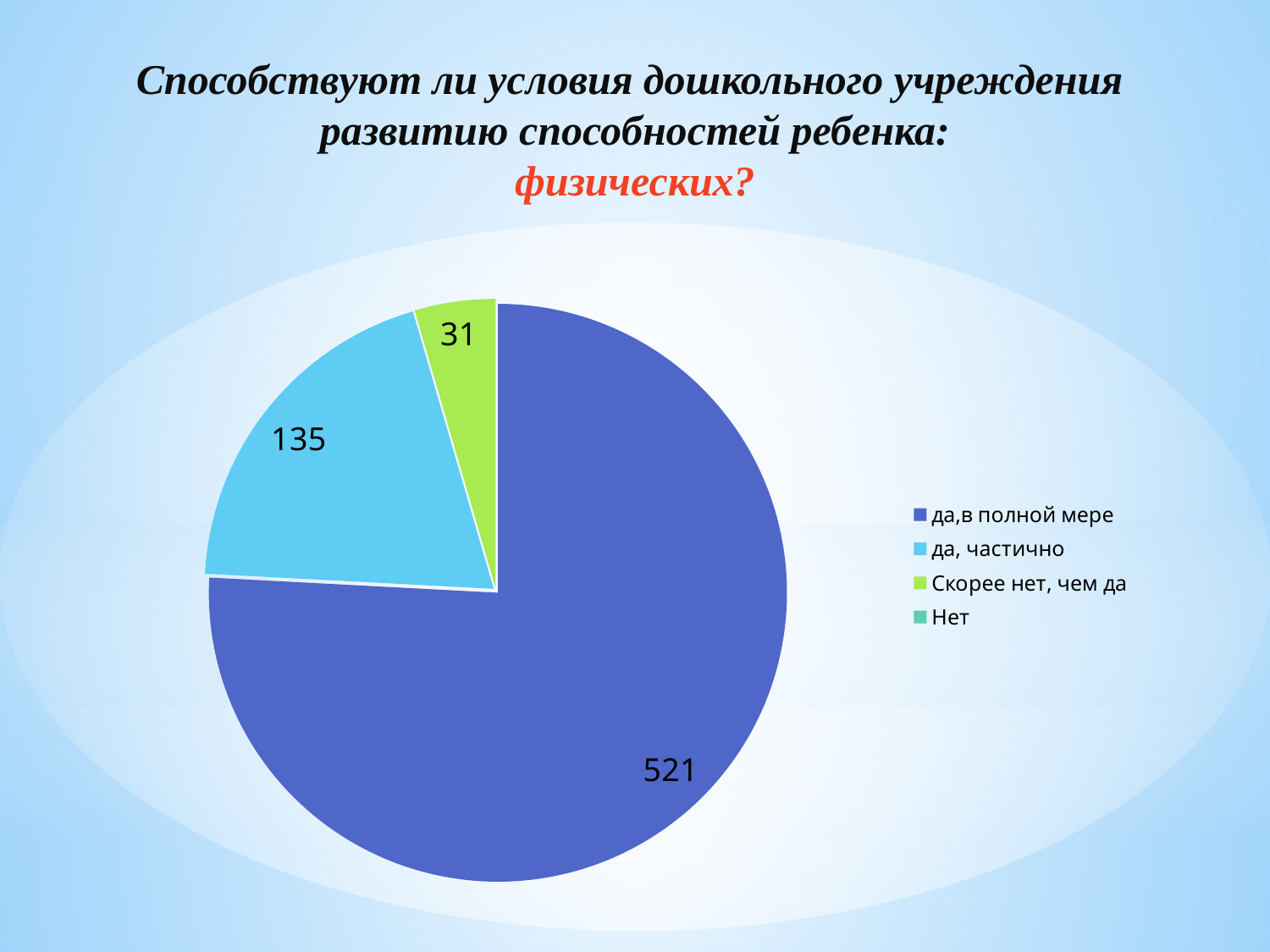
Which category has the largest slice of the pie? да,в полной мере What colour is the slice for "да,в полной мере"? blue What is the difference between the values for "да, частично" and "Скорее нет, чем да"? 104 What is the value for the slice "Скорее нет, чем да"? 31 How many entries does the legend list? 4 What is the difference between the values for "да,в полной мере" and "да, частично"? 386 What is the value for the slice "да,в полной мере"? 521 What kind of chart is shown on the slide? pie chart How many slices have a data label printed on the pie? 3 What is the value for the slice "да, частично"? 135 Which of the labelled slices is the smallest? Скорее нет, чем да Which is larger: the value for "да, частично" or the value for "Скорее нет, чем да"? да, частично